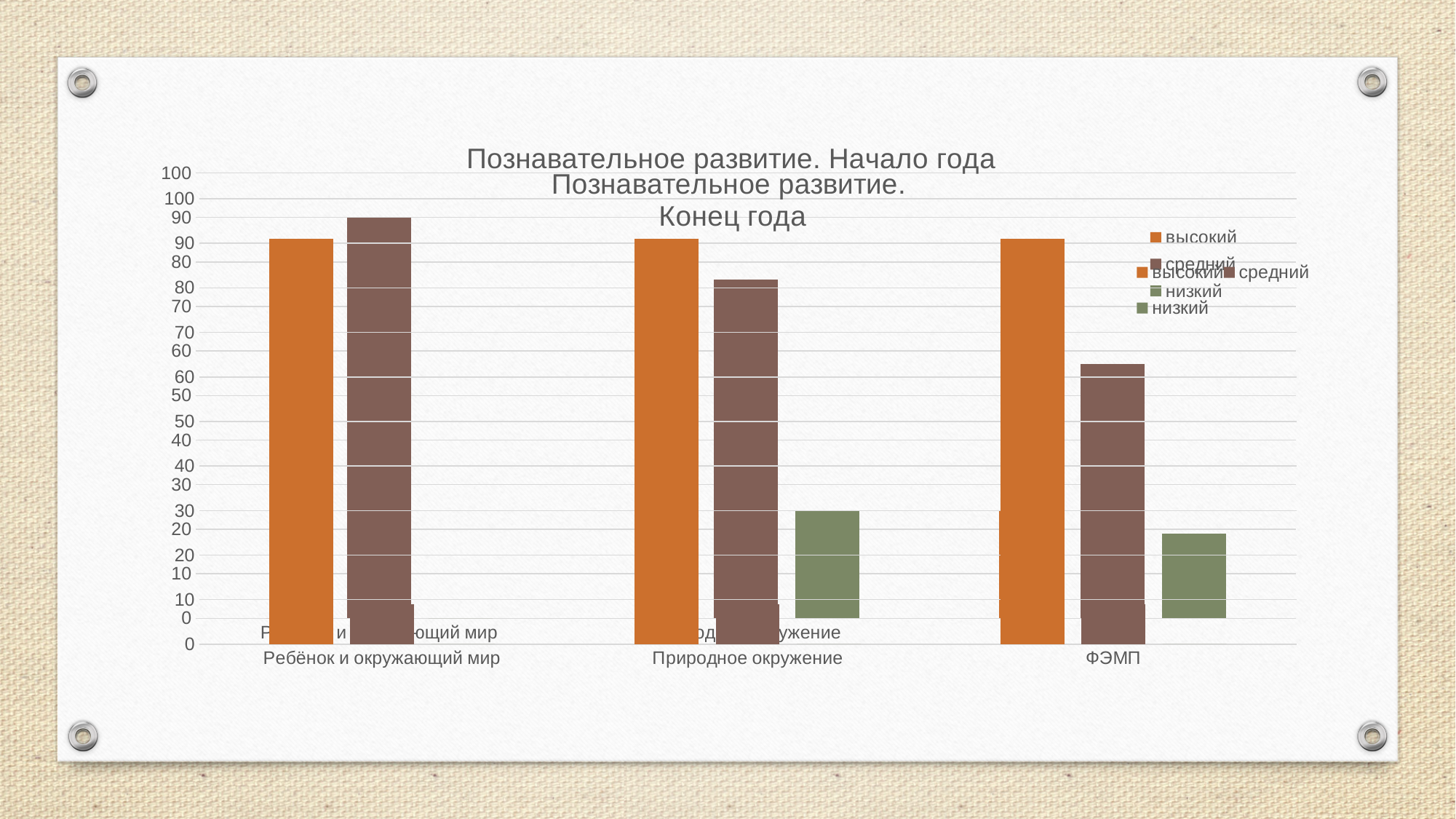
Which series is shown in orange in the legend? высокий What are the titles of the two charts on the slide? Познавательное развитие. Начало года; Познавательное развитие. Конец года How many series does the legend of the chart list? 3 What kind of chart is shown on the slide? bar chart For ФЭМП, which is larger: the высокий value or the низкий value? высокий Is the низкий value for Природное окружение greater or less than 50? less How many categories are shown along the x axis of the chart? 3